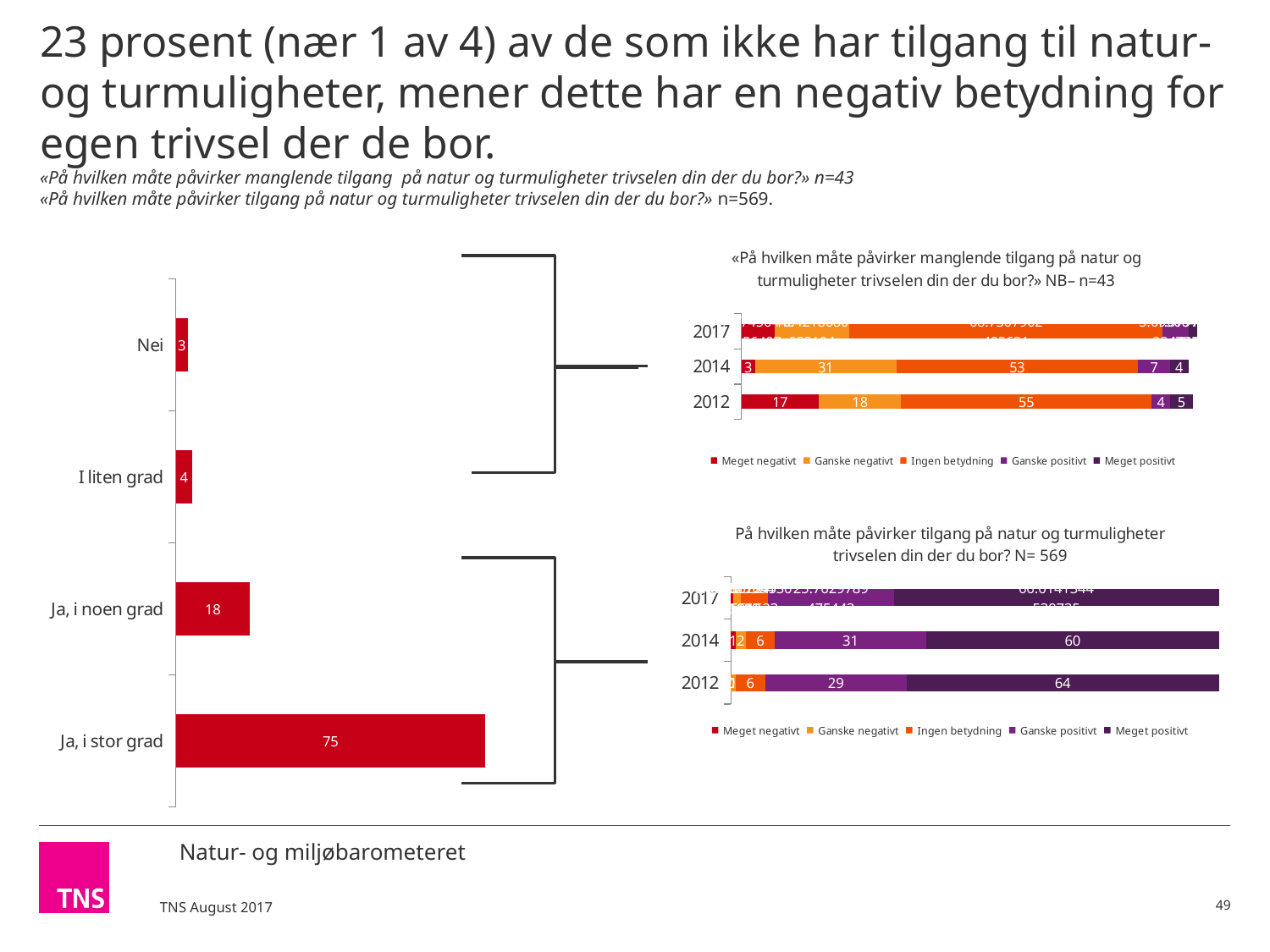
What type of chart is the chart on the left of the slide? Bar chart In the left bar chart, which category has the lowest value? Nei In the left bar chart, what is the value for "Ja, i stor grad"? 75 In the bottom-right chart ("tilgang", N=569), what is the value for "Meget positivt" in 2012? 64 In the bottom-right chart ("tilgang", N=569), which year has the larger value for "Meget positivt", 2012 or 2014? 2012 In the left bar chart, what is the value for "Ja, i noen grad"? 18 In the top-right chart ("manglende tilgang", n=43), what is the value for "Meget negativt" in 2012? 17 How many series does the legend of the top-right chart list? 5 How many categories are shown in the left bar chart? 4 In the left bar chart, what is the difference between the values for "Ja, i stor grad" and "Ja, i noen grad"? 57 In the top-right chart ("manglende tilgang", n=43), what is the value for "Ingen betydning" in 2014? 53 In the left bar chart, which category has the highest value? Ja, i stor grad